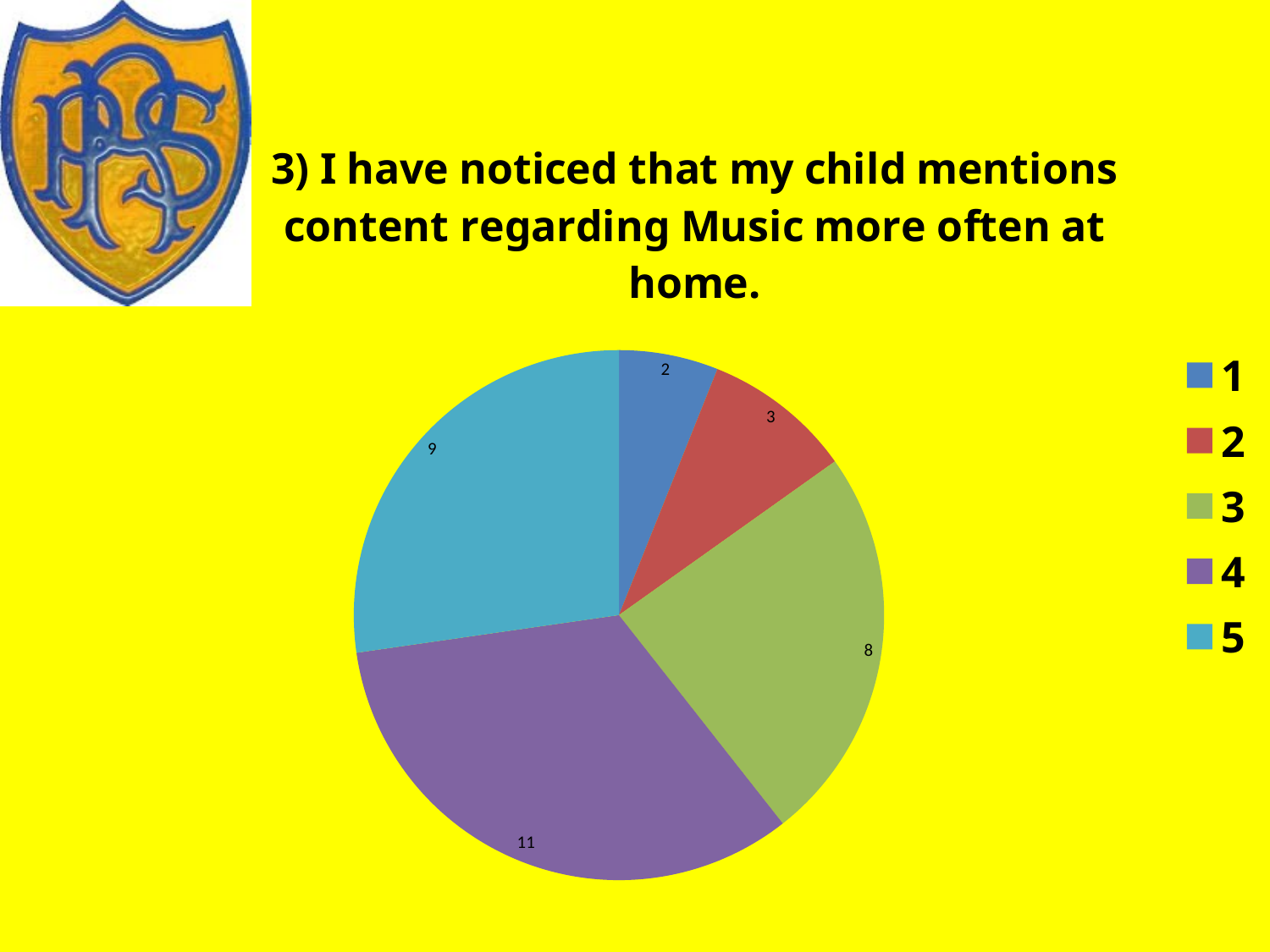
How many slices does the pie chart have? 5 What is the value for category 3 in the pie chart? 8 What is the difference between the values for category 4 and category 5? 2 What colour is the slice for category 5 in the pie chart? light blue What is the value for category 1 in the pie chart? 2 What kind of chart is shown on the slide? pie chart Which category has the smallest slice in the pie chart? 1 What is the total of all the slices in the pie chart? 33 Which is larger, the value for category 3 or the value for category 2? 3 What is the value for category 5 in the pie chart? 9 Which category has the largest slice in the pie chart? 4 What is the value for category 4 in the pie chart? 11